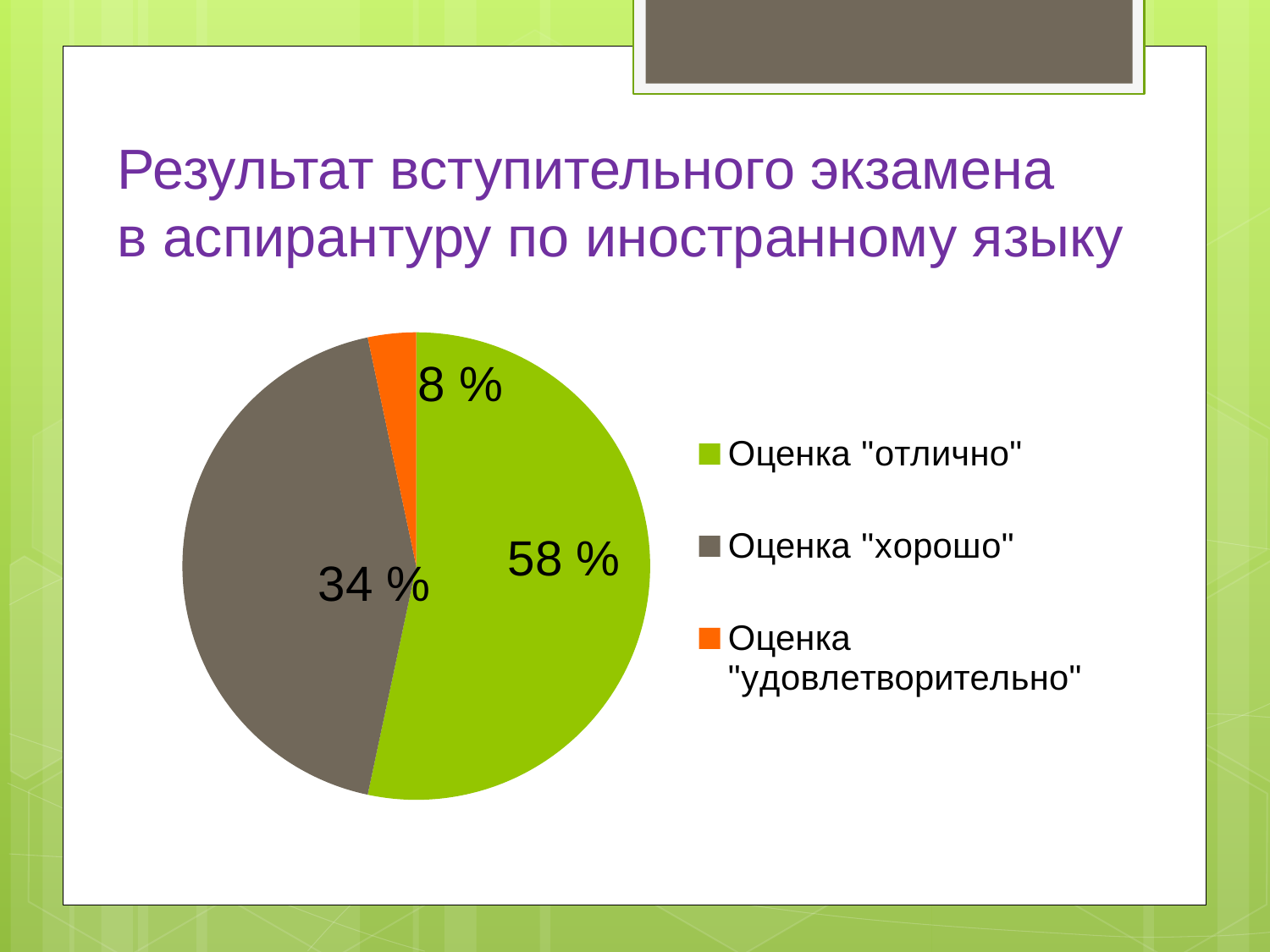
What share of the pie is labelled Оценка "удовлетворительно"? 8 % What is the difference between the shares for Оценка "отлично" and Оценка "хорошо"? 24 % Which is larger: the share for Оценка "хорошо" or the share for Оценка "удовлетворительно"? Оценка "хорошо" Which category has the smallest slice of the pie? Оценка "удовлетворительно" What is the difference between the shares for Оценка "хорошо" and Оценка "удовлетворительно"? 26 % What share of the pie is labelled Оценка "хорошо"? 34 % Which category has the largest slice of the pie? Оценка "отлично" What is the title of the slide containing the pie chart? Результат вступительного экзамена в аспирантуру по иностранному языку How many slices does the pie chart have? 3 What colour is the slice for Оценка "удовлетворительно"? orange What kind of chart is shown on the slide? pie chart What share of the pie is labelled Оценка "отлично"? 58 %